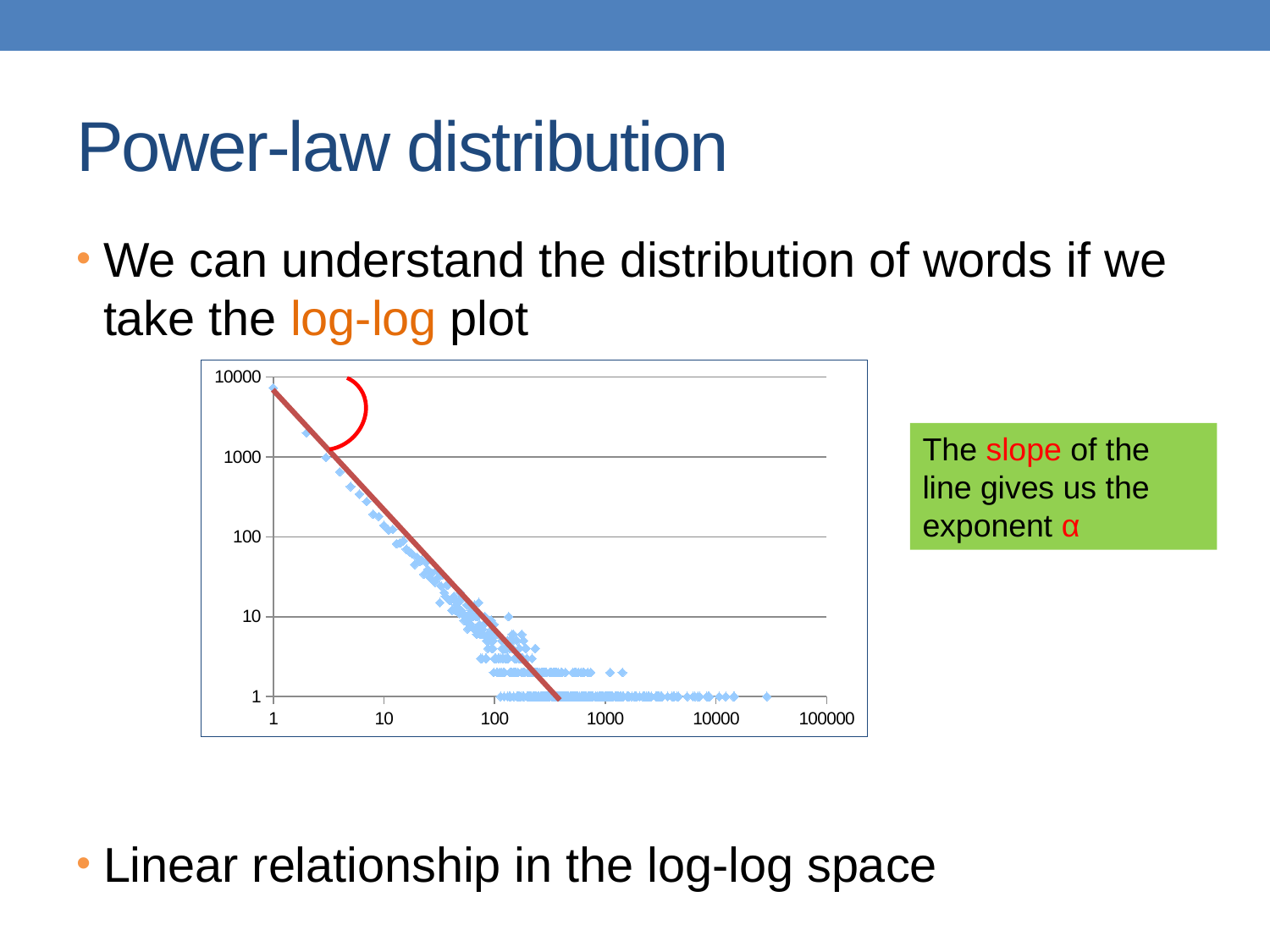
What kind of chart is shown on the slide? scatter chart Is the plotted value at x = 10 greater or less than 100? greater Are the plotted values at x = 10000 greater or less than 10? less Do the plotted values rise or fall as the x-axis value increases? fall How many tick labels are shown on the x axis? 6 Is the highest plotted value on the chart greater or less than 1000? greater How many tick labels are shown on the y axis? 5 What is the largest tick label shown on the y axis? 10000 What is the largest tick label shown on the x axis? 100000